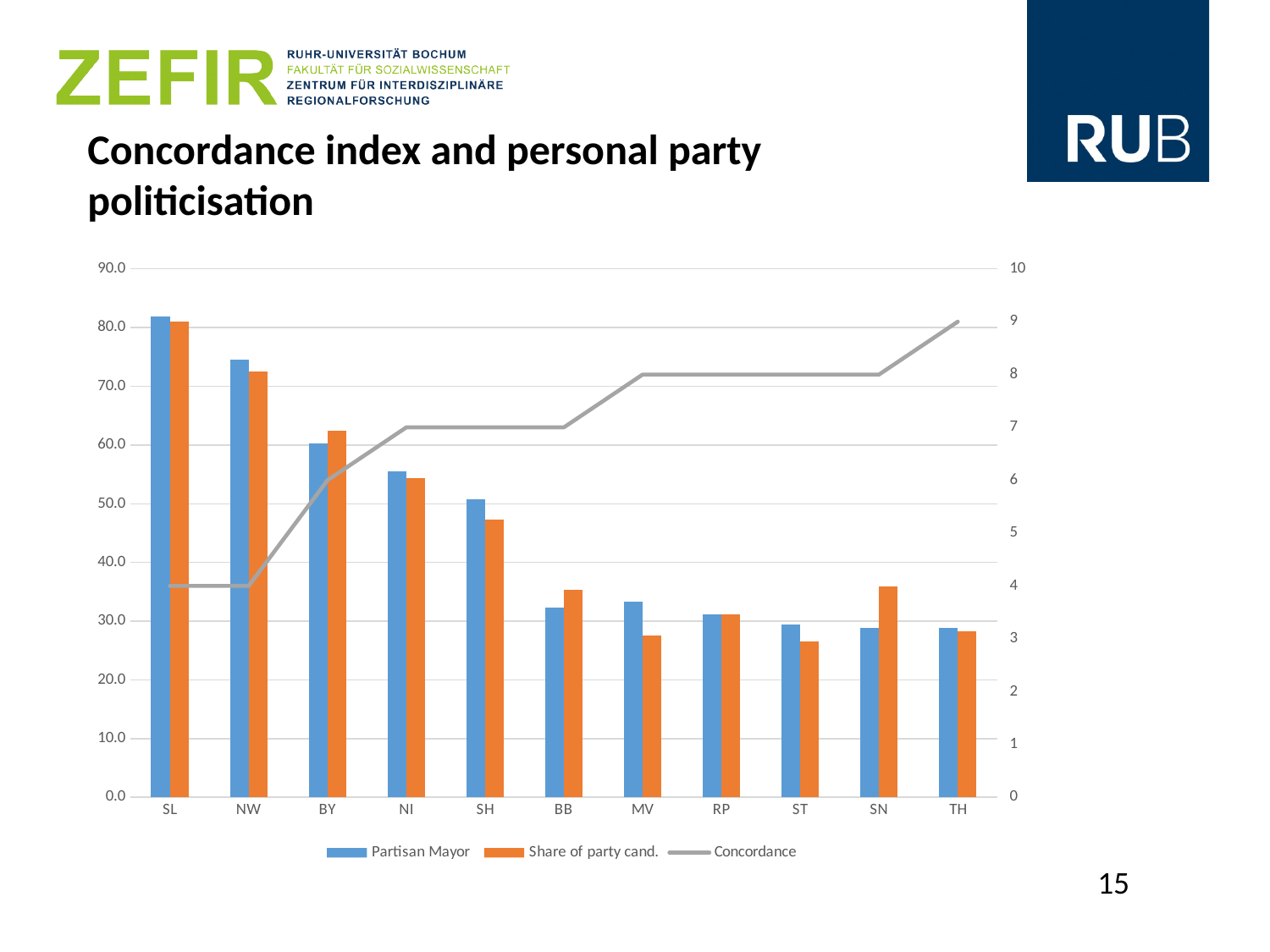
How many series does the legend list? 3 Is the Partisan Mayor value for NW greater or less than 70.0? greater For MV, which is larger: Partisan Mayor or Share of party cand.? Partisan Mayor Is the Share of party cand. value for SN greater or less than 30.0? greater How many categories are shown on the x axis? 11 What is the Concordance value for SL? 4 What is the Concordance value for NI? 7 Is the Share of party cand. value for MV greater or less than 30.0? less For SN, which is larger: Partisan Mayor or Share of party cand.? Share of party cand. What is the Concordance value for TH? 9 Which category has the lowest Concordance value? SL and NW Which category has the highest Partisan Mayor value? SL